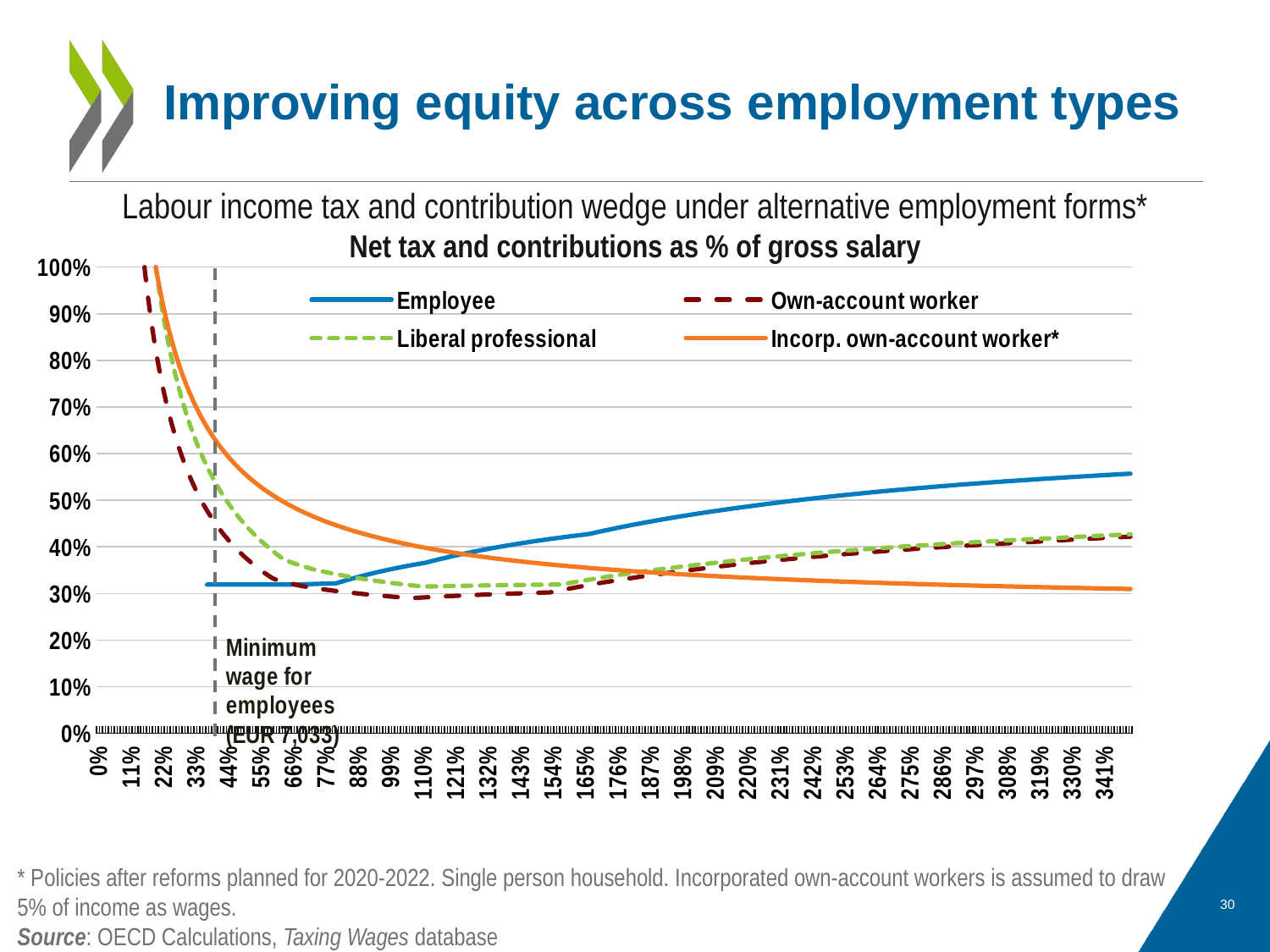
What kind of chart is shown on the slide? Line chart Is the value for Incorp. own-account worker at 341% greater or less than 40%? less Does the Incorp. own-account worker series rise or fall along the x axis? Falls Which series is plotted with a solid blue line? Employee At the minimum wage line (around 44%), which is larger: Employee or Incorp. own-account worker? Incorp. own-account worker Does the Employee series rise or fall as gross salary increases beyond the minimum wage? Rises Which series has the highest value at the right end of the chart (341%)? Employee At 341%, which is larger: Employee or Liberal professional? Employee Is the value for Employee at 341% greater or less than 50%? greater What does the dashed vertical line on the chart mark? Minimum wage for employees (EUR 7,033) Which series has the lowest value at the right end of the chart (341%)? Incorp. own-account worker How many series does the legend list? 4